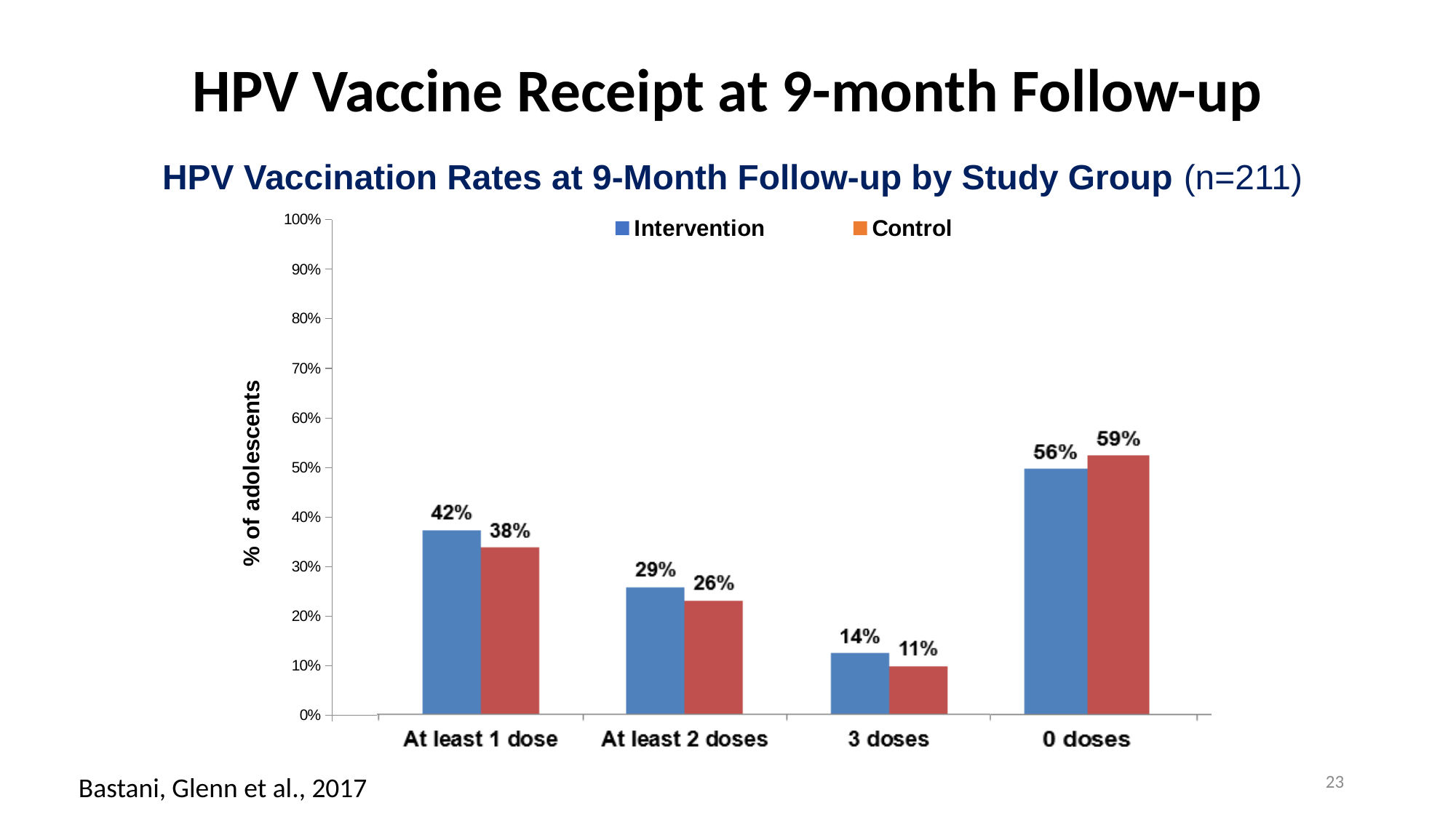
What is the Control value for 3 doses? 11% What kind of chart is shown? Bar chart Which category has the highest Intervention value? 0 doses What is the Intervention value for At least 2 doses? 29% What is the y-axis label of the chart? % of adolescents What is the difference between the Intervention and Control values for At least 1 dose? 4% For 0 doses, which is larger, Intervention or Control? Control Which category has the lowest Control value? 3 doses How many categories are shown on the x axis? 4 What is the Control value for 0 doses? 59% How many series does the legend list? 2 What is the Intervention value for At least 1 dose? 42%